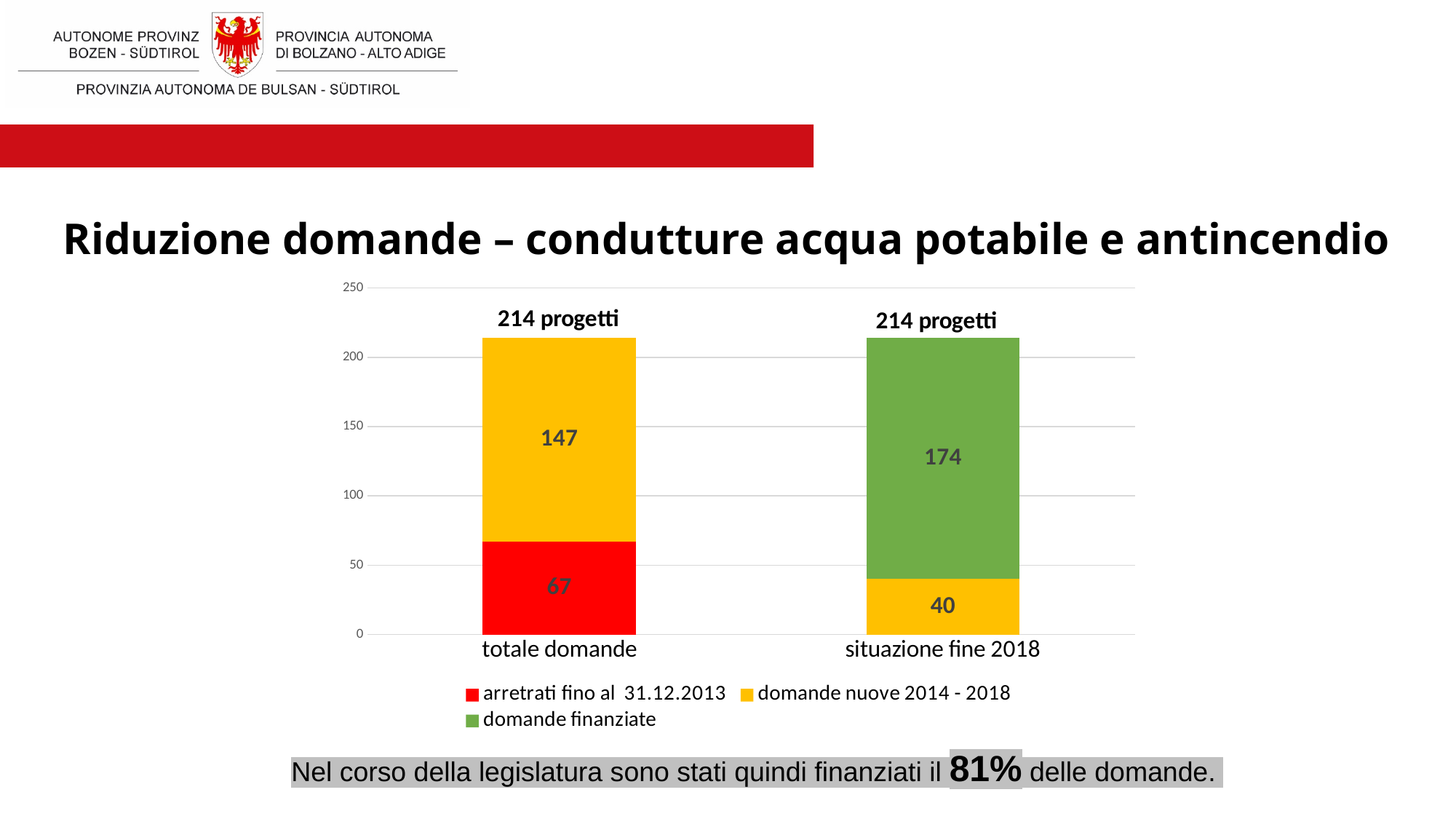
Which is larger: 'domande finanziate' for 'situazione fine 2018' or 'domande nuove 2014 - 2018' for 'totale domande'? domande finanziate for situazione fine 2018 What is the value of 'arretrati fino al 31.12.2013' for 'totale domande'? 67 How many categories are shown on the x axis? 2 What is the total of the stacked bar for 'situazione fine 2018'? 214 What is the value of 'domande finanziate' for 'situazione fine 2018'? 174 What is the difference between 'domande nuove 2014 - 2018' for 'totale domande' and for 'situazione fine 2018'? 107 What kind of chart is shown on the slide? Stacked bar chart What is the total of the stacked bar for 'totale domande'? 214 What is the value of 'domande nuove 2014 - 2018' for 'totale domande'? 147 What is the value of 'domande nuove 2014 - 2018' for 'situazione fine 2018'? 40 Which colour represents 'domande finanziate' in the chart? Green How many series does the legend list? 3